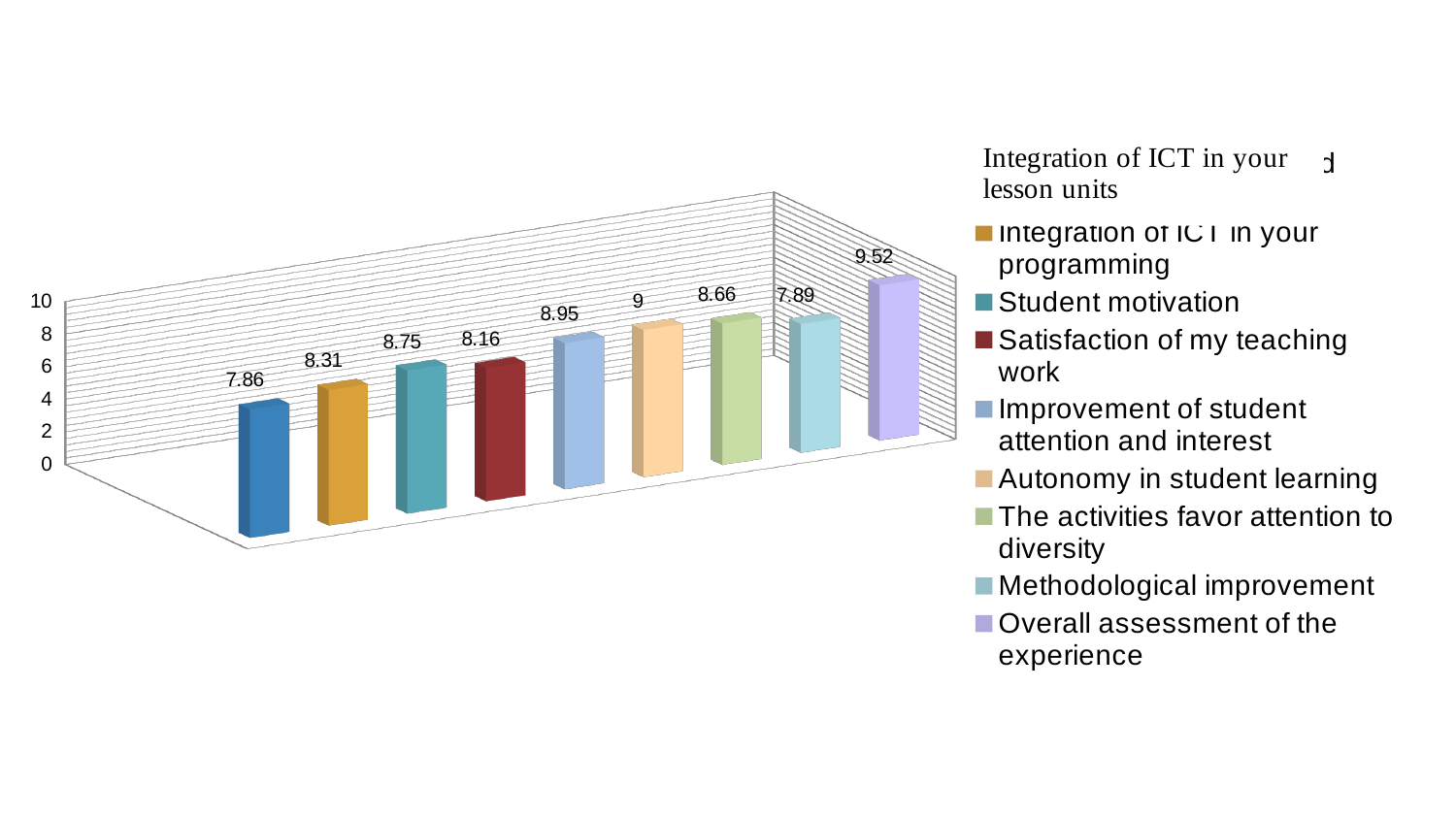
What kind of chart is shown on the slide? bar chart What is the value for Satisfaction of my teaching work? 8.16 What is the value for Overall assessment of the experience? 9.52 What is the value for Student motivation? 8.75 Which series has the lowest value? Integration of ICT in your lesson units What is the value for Autonomy in student learning? 9 What is the difference between the values for Overall assessment of the experience and Integration of ICT in your programming? 1.21 How many series does the legend list? 9 What is the value for Methodological improvement? 7.89 Which is larger, the value for Improvement of student attention and interest or the value for The activities favor attention to diversity? Improvement of student attention and interest How many bars are plotted in the chart? 9 Which series has the highest value? Overall assessment of the experience